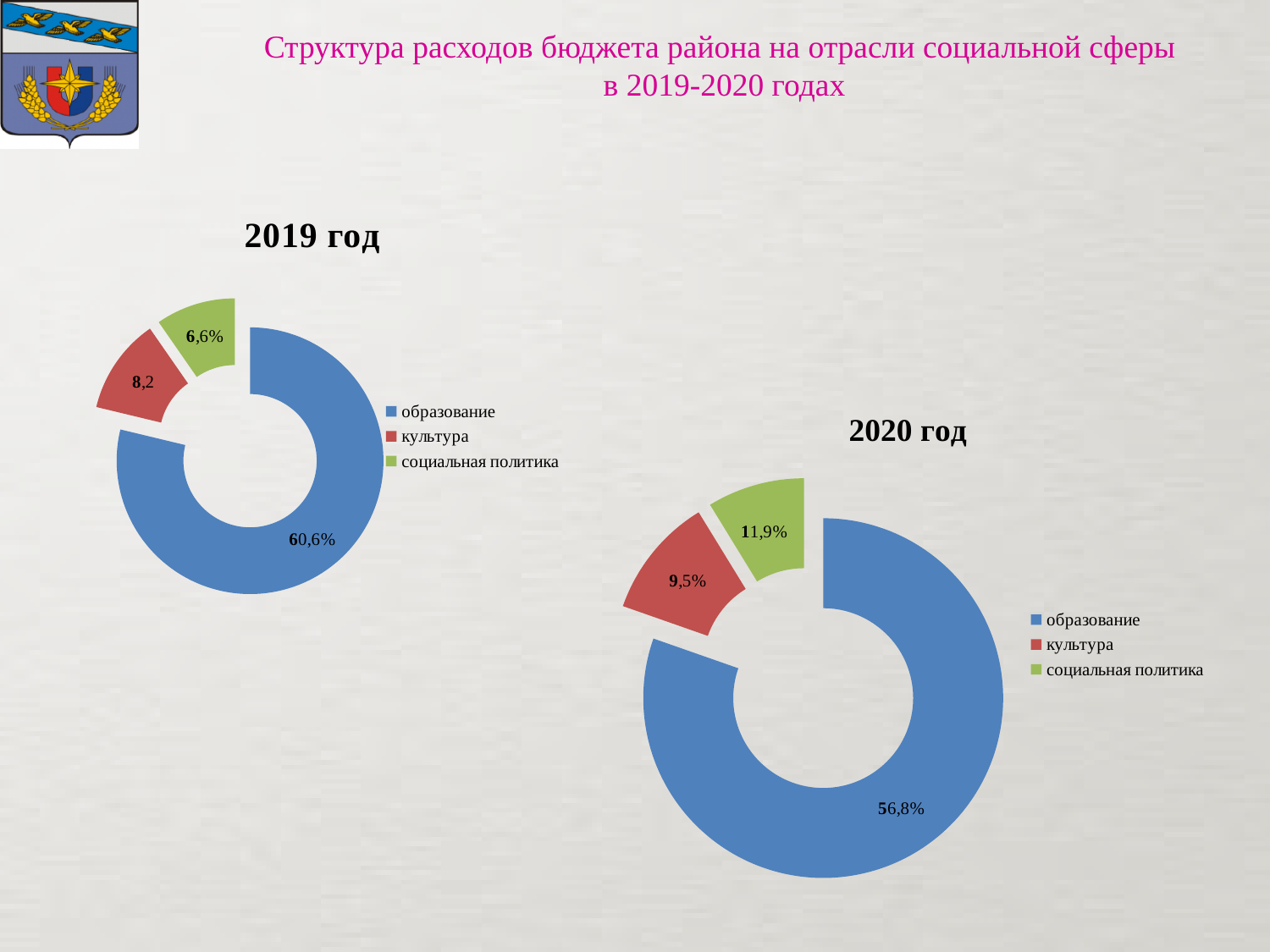
In the 2020 год chart, what is the value shown for культура? 9,5% In the 2019 год chart, which category has the smallest share? социальная политика In the 2020 год chart, what is the value shown for социальная политика? 11,9% In the 2020 год chart, which category has the largest share? образование In the 2019 год chart, what is the value shown for социальная политика? 6,6% How many categories does the legend of the 2019 год chart list? 3 In the 2020 год chart, what is the difference between the values for социальная политика and культура? 2,4% In the 2020 год chart, which is larger: культура or социальная политика? социальная политика In the 2020 год chart, what is the value shown for образование? 56,8% In the 2019 год chart, what is the value shown for культура? 8,2 What type of chart is the 2020 год chart? doughnut chart In the 2019 год chart, what is the value shown for образование? 60,6%